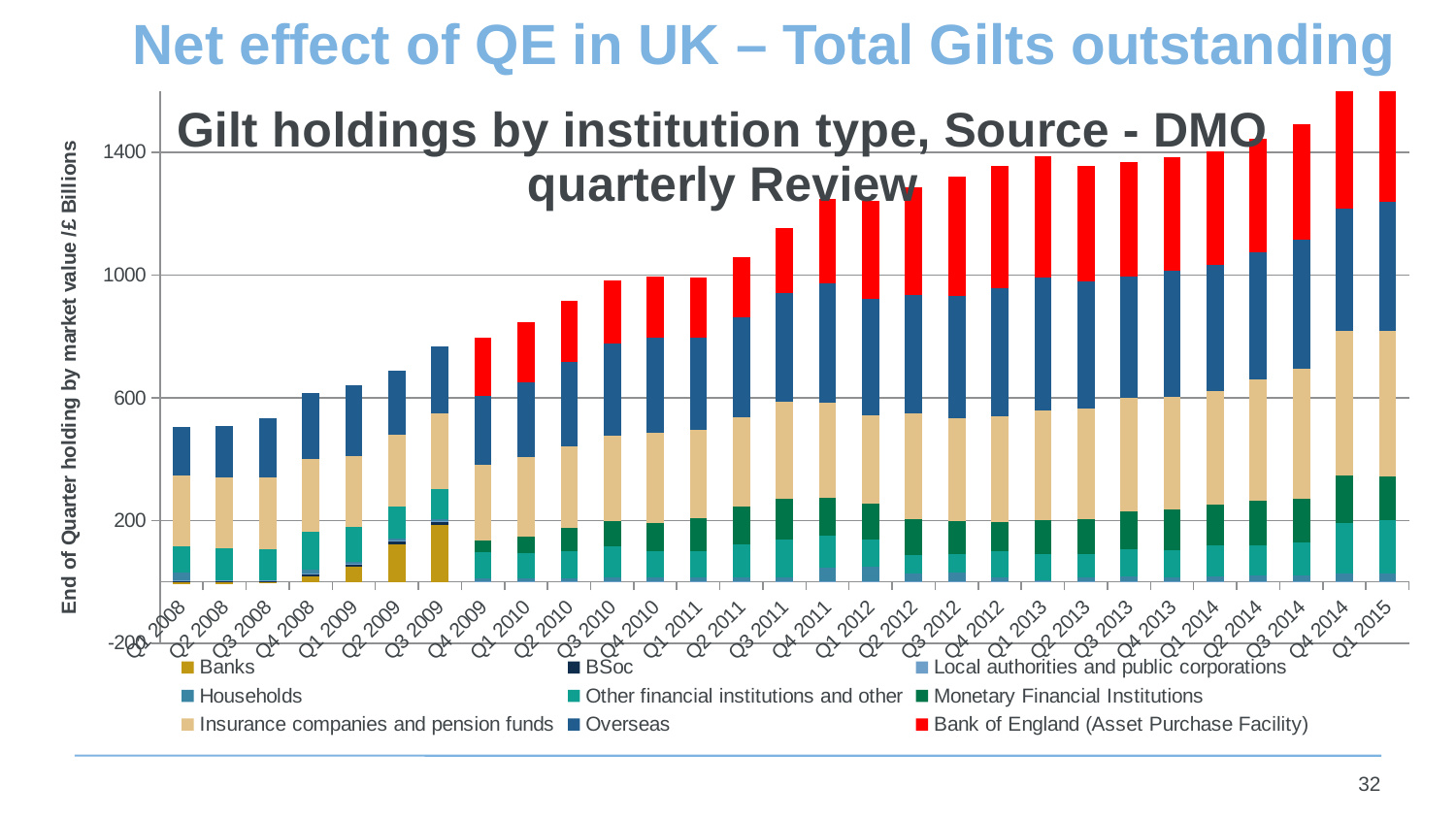
How many series does the legend list? 9 Do the total gilt holdings generally rise or fall from Q1 2008 to Q1 2015? Rise Is the total bar height for Q3 2011 greater or less than 1000? greater Is the total bar height for Q1 2010 greater or less than 1000? less Is the total bar height for Q1 2008 greater or less than 600? less What is the title of the chart? Gilt holdings by institution type, Source - DMO quarterly Review Which has the larger total bar, Q1 2008 or Q1 2015? Q1 2015 Which series is shown in red in the legend? Bank of England (Asset Purchase Facility) What kind of chart is shown on the slide? Stacked bar chart How many quarters are plotted along the x axis? 29